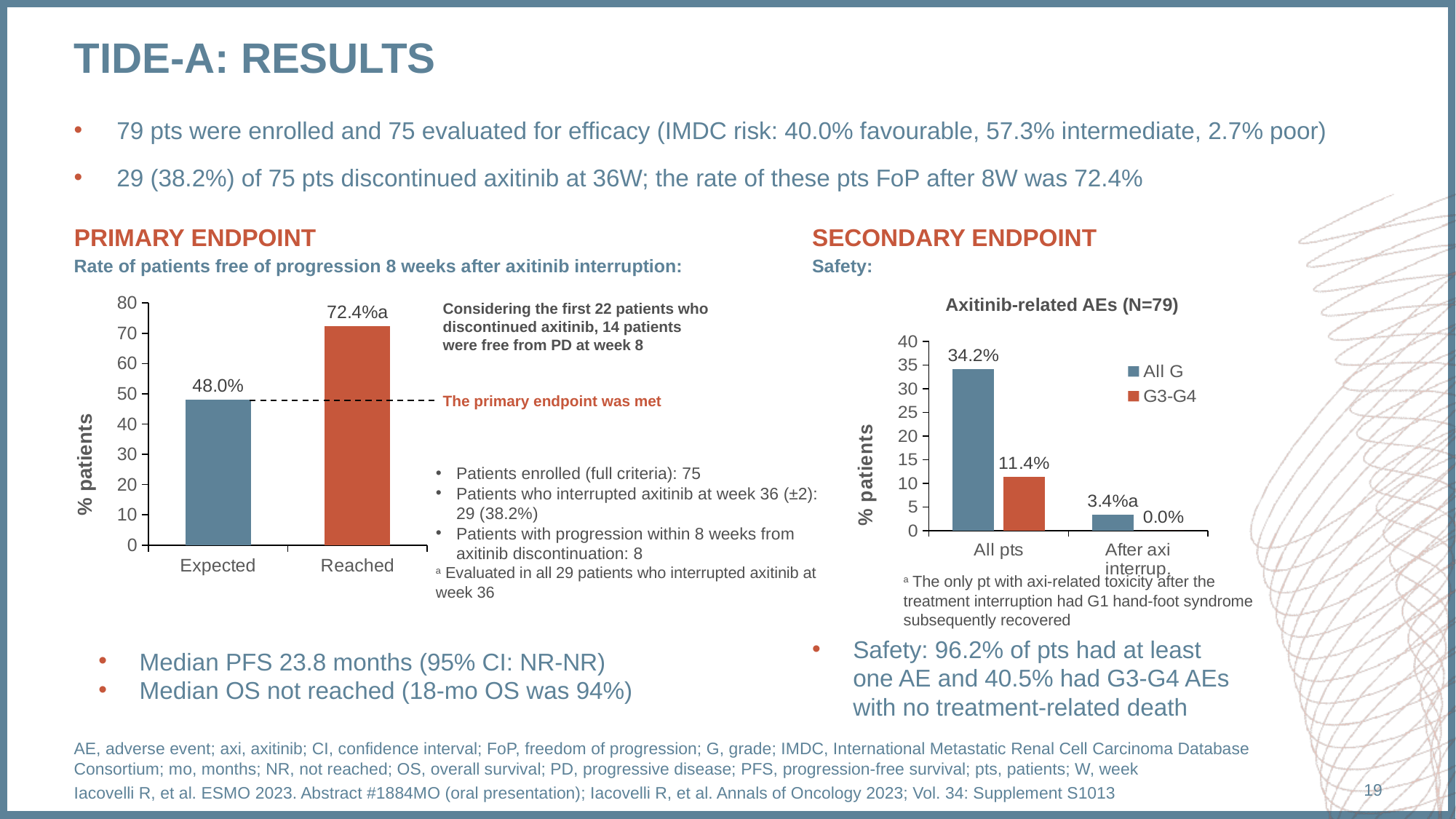
In the left chart (rate of patients free of progression 8 weeks after axitinib interruption), what is the value for Reached? 72.4% In the left chart (rate of patients free of progression 8 weeks after axitinib interruption), which category has the higher value, Expected or Reached? Reached What kind of chart is the left chart (rate of patients free of progression 8 weeks after axitinib interruption)? Bar chart In the 'Axitinib-related AEs (N=79)' chart, what is the All G value for All pts? 34.2% In the left chart (rate of patients free of progression 8 weeks after axitinib interruption), what is the value for Expected? 48.0% In the left chart (rate of patients free of progression 8 weeks after axitinib interruption), what is the difference between the Reached and Expected values? 24.4% In the 'Axitinib-related AEs (N=79)' chart, what is the All G value for After axi interrup.? 3.4% In the 'Axitinib-related AEs (N=79)' chart, what is the difference between the All G and G3-G4 values for All pts? 22.8% In the 'Axitinib-related AEs (N=79)' chart, which series is shown in red? G3-G4 In the 'Axitinib-related AEs (N=79)' chart, what is the G3-G4 value for After axi interrup.? 0.0% In the 'Axitinib-related AEs (N=79)' chart, what is the G3-G4 value for All pts? 11.4% How many series does the legend of the 'Axitinib-related AEs (N=79)' chart list? 2